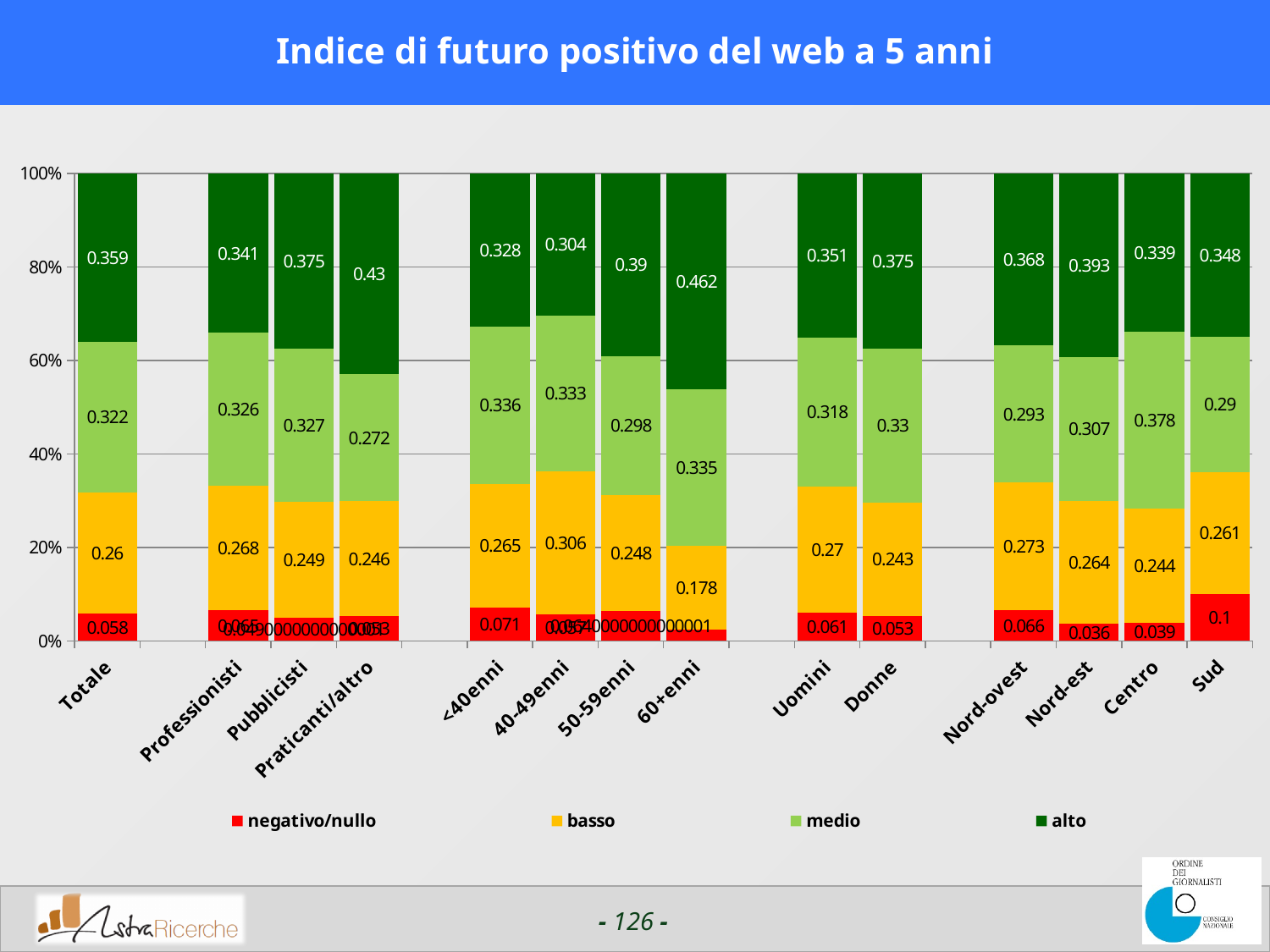
What kind of chart is shown on the slide? Stacked bar chart What is the 'negativo/nullo' value for Sud? 0.1 What is the title of the chart? Indice di futuro positivo del web a 5 anni Which category has the lowest 'alto' value? 40-49enni Which has the larger 'alto' value, Nord-est or Nord-ovest? Nord-est How many series does the legend list? 4 What is the 'alto' value for Totale? 0.359 What is the 'medio' value for Centro? 0.378 How many categories are shown on the x axis? 14 Which category has the highest 'alto' value? 60+enni What is the difference between the 'alto' values for Donne and Uomini? 0.024 What is the 'basso' value for 60+enni? 0.178